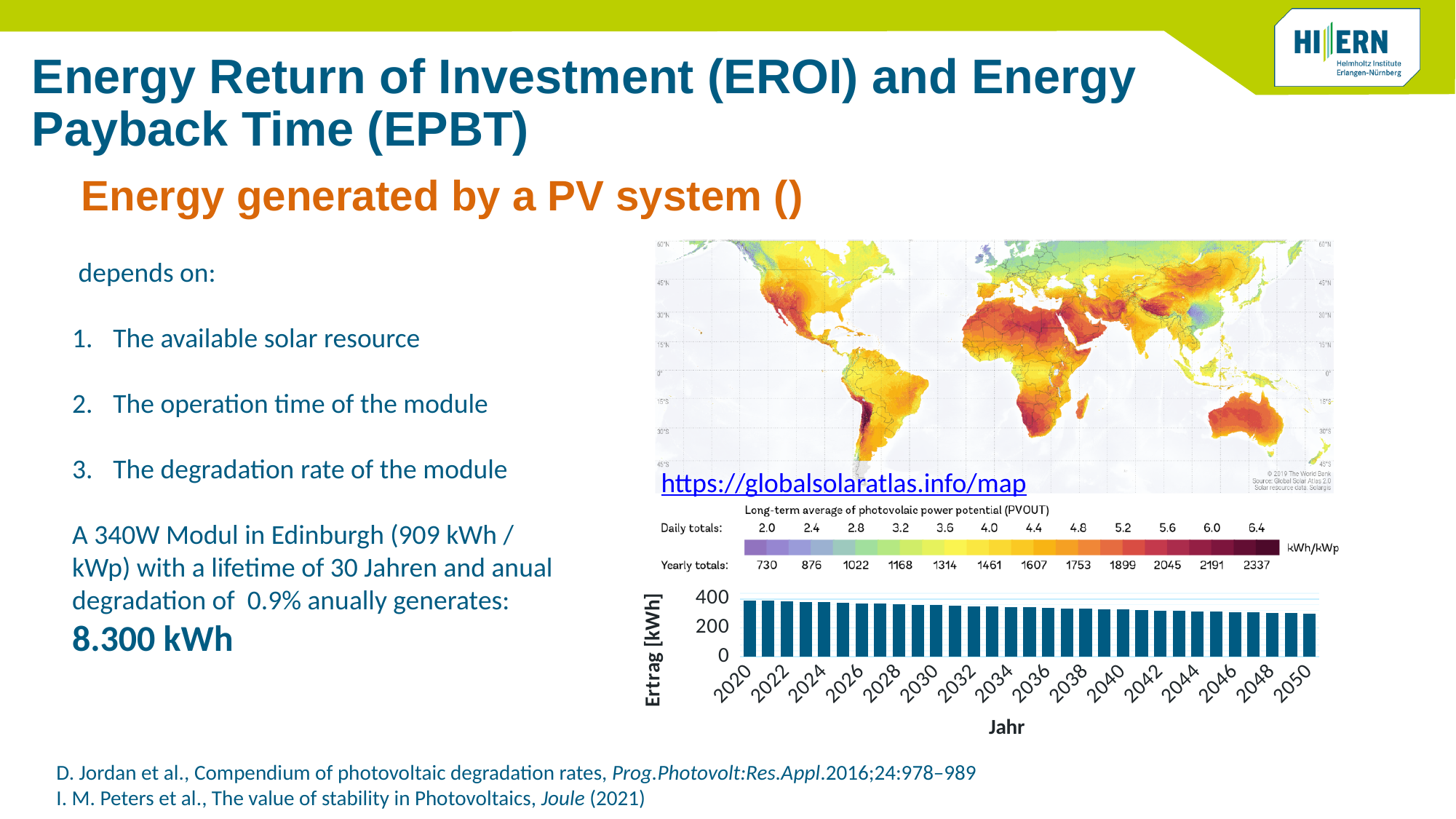
In the Ertrag [kWh] bar chart, is the value for 2020 greater or less than 200? greater How many year labels are shown on the x axis of the Ertrag [kWh] bar chart? 16 In the Ertrag [kWh] bar chart, which year has the highest value? 2020 In the Ertrag [kWh] bar chart, do the values rise or fall from 2020 to 2050? fall In the Ertrag [kWh] bar chart, which year has the larger value, 2020 or 2050? 2020 In the Ertrag [kWh] bar chart, is the value for 2050 greater or less than 200? greater In the Ertrag [kWh] bar chart, is the value for 2050 greater or less than 400? less What is the label of the y axis of the bar chart at the bottom right of the slide? Ertrag [kWh] What is the label of the x axis of the bar chart at the bottom right of the slide? Jahr What kind of chart is shown at the bottom right of the slide (Ertrag vs Jahr)? bar chart In the Ertrag [kWh] bar chart, which year has the lowest value? 2050